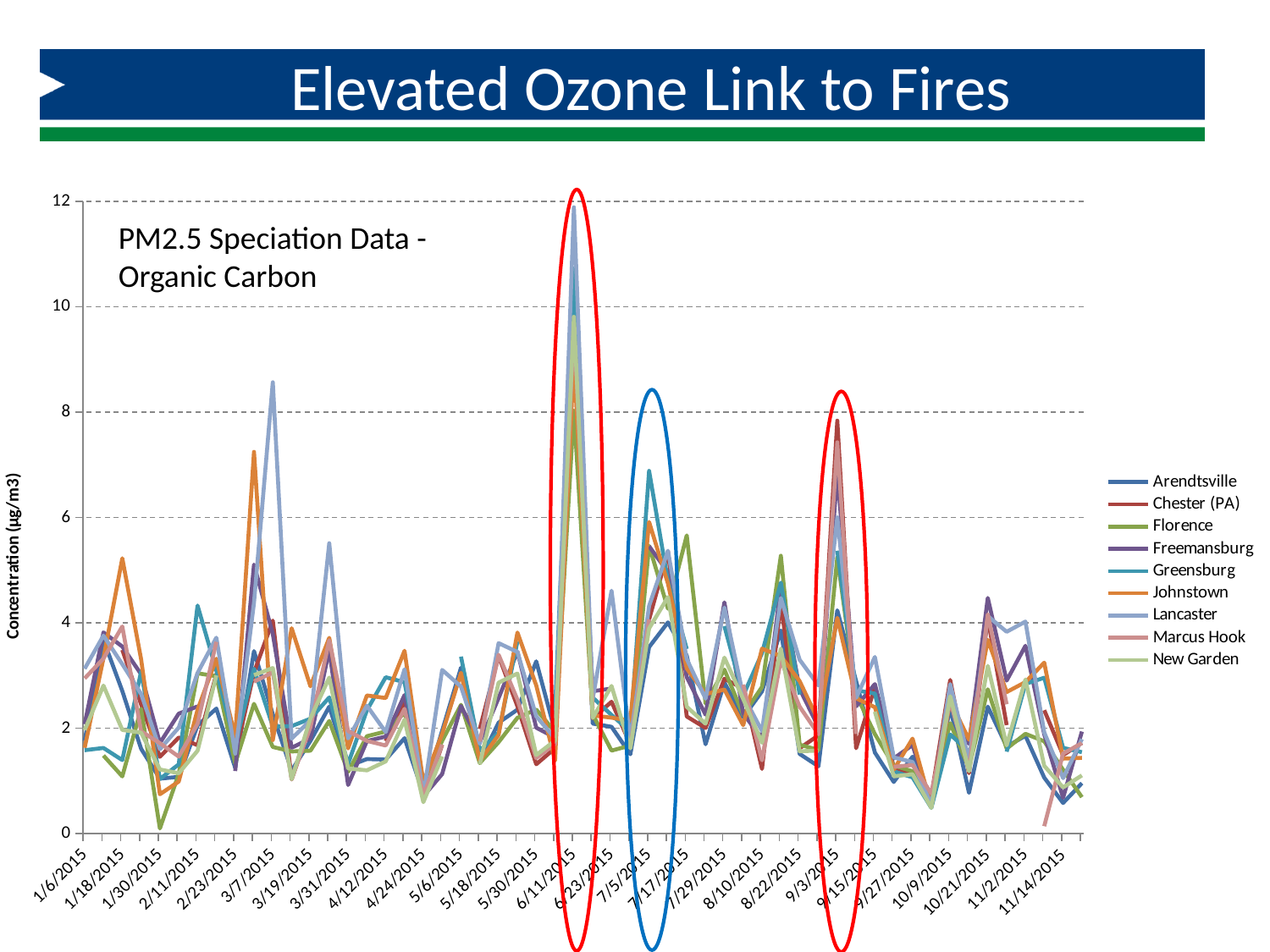
Is the Lancaster value around 3/7/2015 greater or less than 8? greater What is the title shown inside the chart area? PM2.5 Speciation Data - Organic Carbon Is the highest value plotted around 9/3/2015 greater or less than 6? greater What is the label on the y axis? Concentration (µg/m3) Is the Florence value around 1/30/2015 greater or less than 1? less Which series reaches the highest value anywhere on the chart? Lancaster What kind of chart is shown on the slide? line chart How many series does the legend list? 9 Which series has the highest value around 7/5/2015? Greensburg